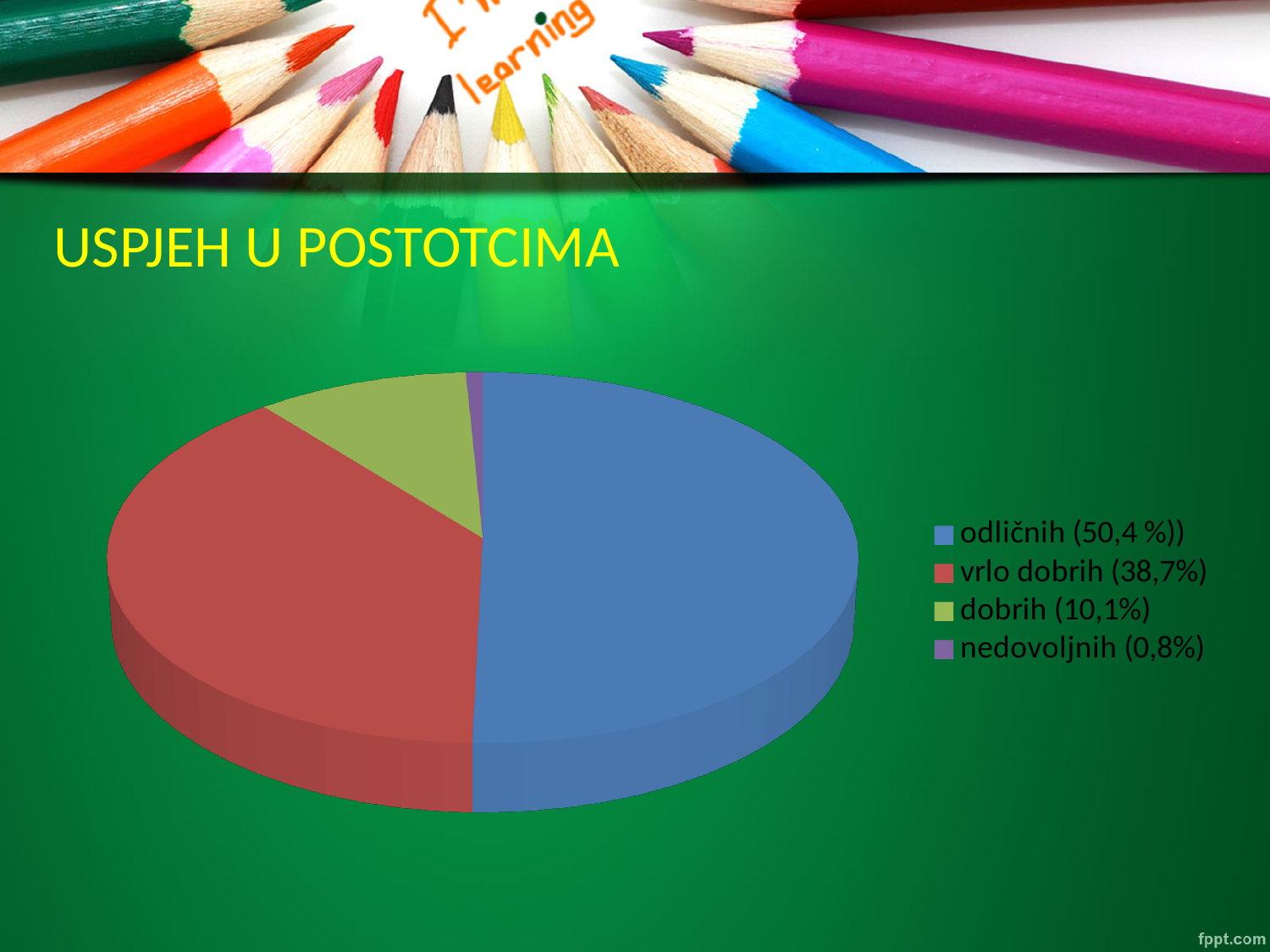
What percentage is shown for 'vrlo dobrih' in the legend? 38,7% What is the title of the chart? USPJEH U POSTOTCIMA Which category has the smallest slice of the pie? nedovoljnih How many categories does the legend of the pie chart list? 4 What percentage is shown for 'dobrih' in the legend? 10,1% Which is larger, the share for 'vrlo dobrih' or the share for 'dobrih'? vrlo dobrih What kind of chart is shown on the slide? pie chart What is the difference in percentage points between 'odličnih' and 'vrlo dobrih'? 11,7 What percentage is shown for 'odličnih' in the legend? 50,4 % Which category has the largest slice of the pie? odličnih What percentage is shown for 'nedovoljnih' in the legend? 0,8% What colour is the slice for 'dobrih'? green